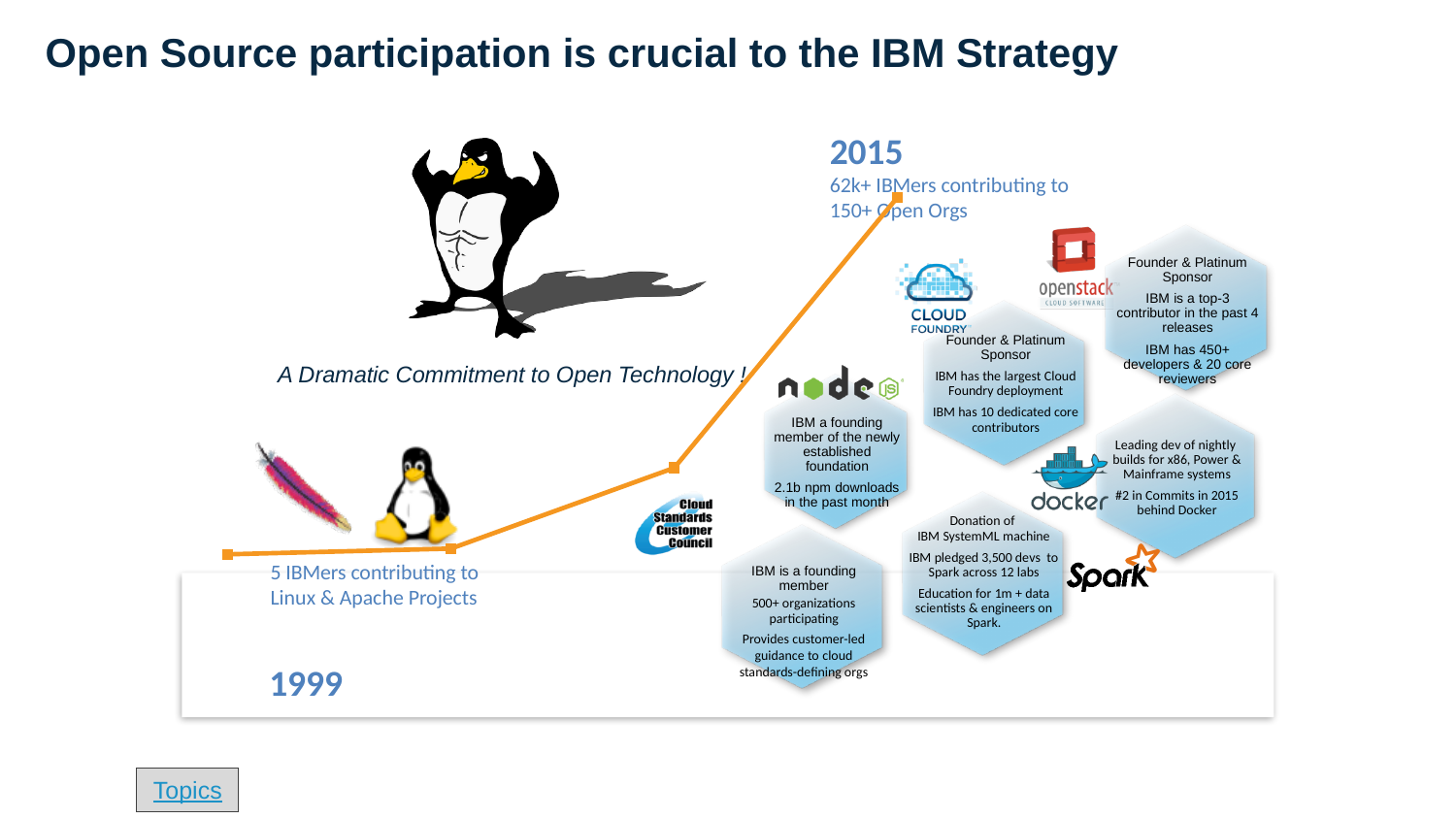
What year is labelled at the start of the orange line? 1999 According to the label at the 1999 point, how many IBMers were contributing to Linux & Apache projects? 5 Which labelled year has the lowest point on the orange line? 1999 What kind of chart is used to show the growth of IBM's open source participation from 1999 to 2015? line chart Does the orange line rise or fall from 1999 to 2015? rise Which year has the higher value on the orange line, 1999 or 2015? 2015 What year is labelled at the end of the orange line? 2015 According to the label at the 2015 point, how many IBMers were contributing to open orgs? 62k+ According to the label at the 2015 point, how many open orgs were IBMers contributing to? 150+ Which labelled year has the highest point on the orange line? 2015 How many data points (markers) are plotted on the orange line? 4